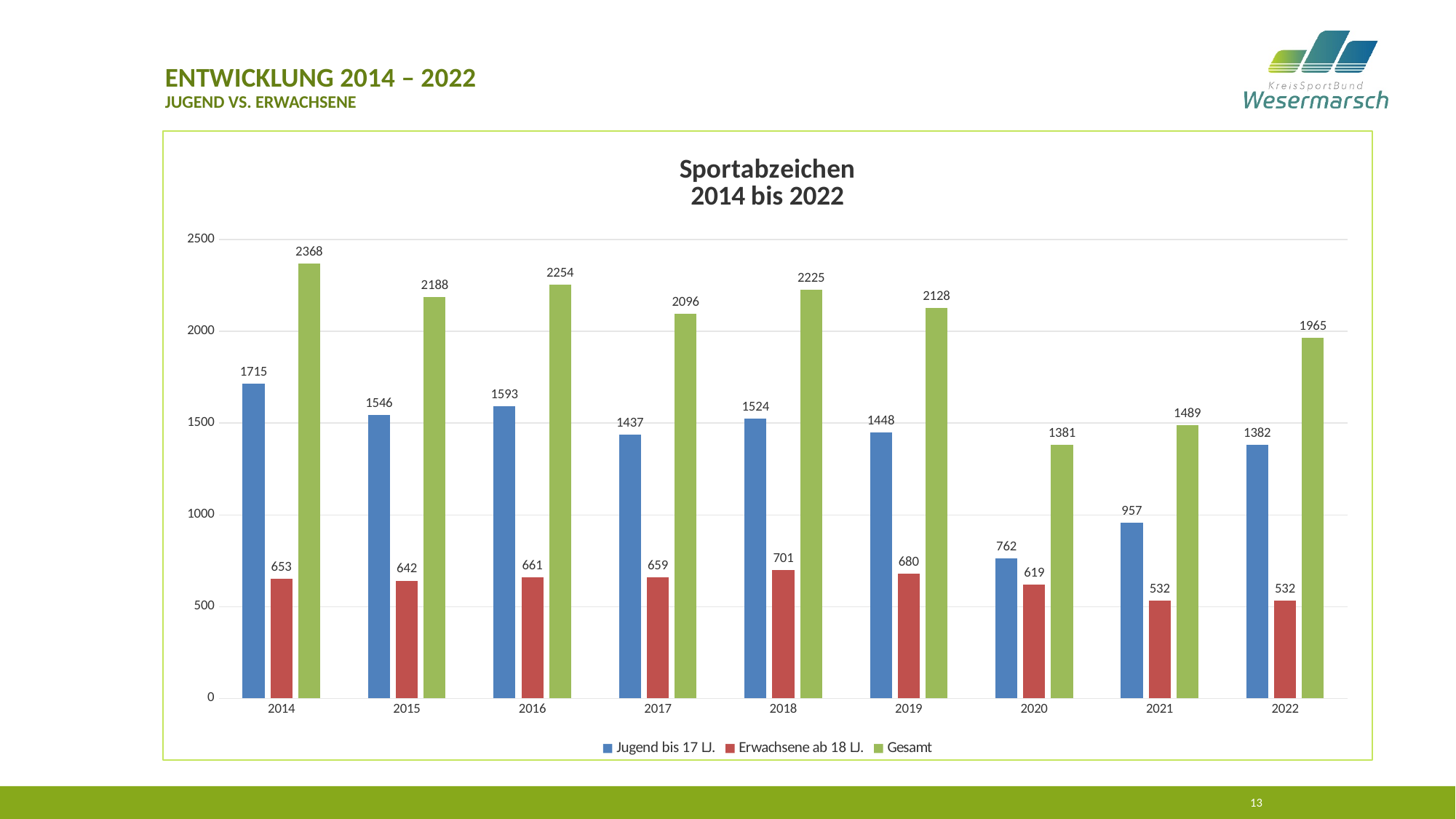
What kind of chart is shown? Bar chart How many years are shown on the x axis? 9 What is the value for Gesamt in 2014? 2368 What is the title of the chart? Sportabzeichen 2014 bis 2022 How many series does the legend list? 3 What is the value for Jugend bis 17 LJ. in 2021? 957 What is the value for Erwachsene ab 18 LJ. in 2018? 701 In which year is the Jugend bis 17 LJ. value highest? 2014 Which is larger, the Jugend bis 17 LJ. value in 2016 or in 2015? 2016 In which year is the Gesamt value lowest? 2020 Does the Erwachsene ab 18 LJ. value rise or fall from 2019 to 2022? Fall What is the difference between the Gesamt values for 2014 and 2022? 403